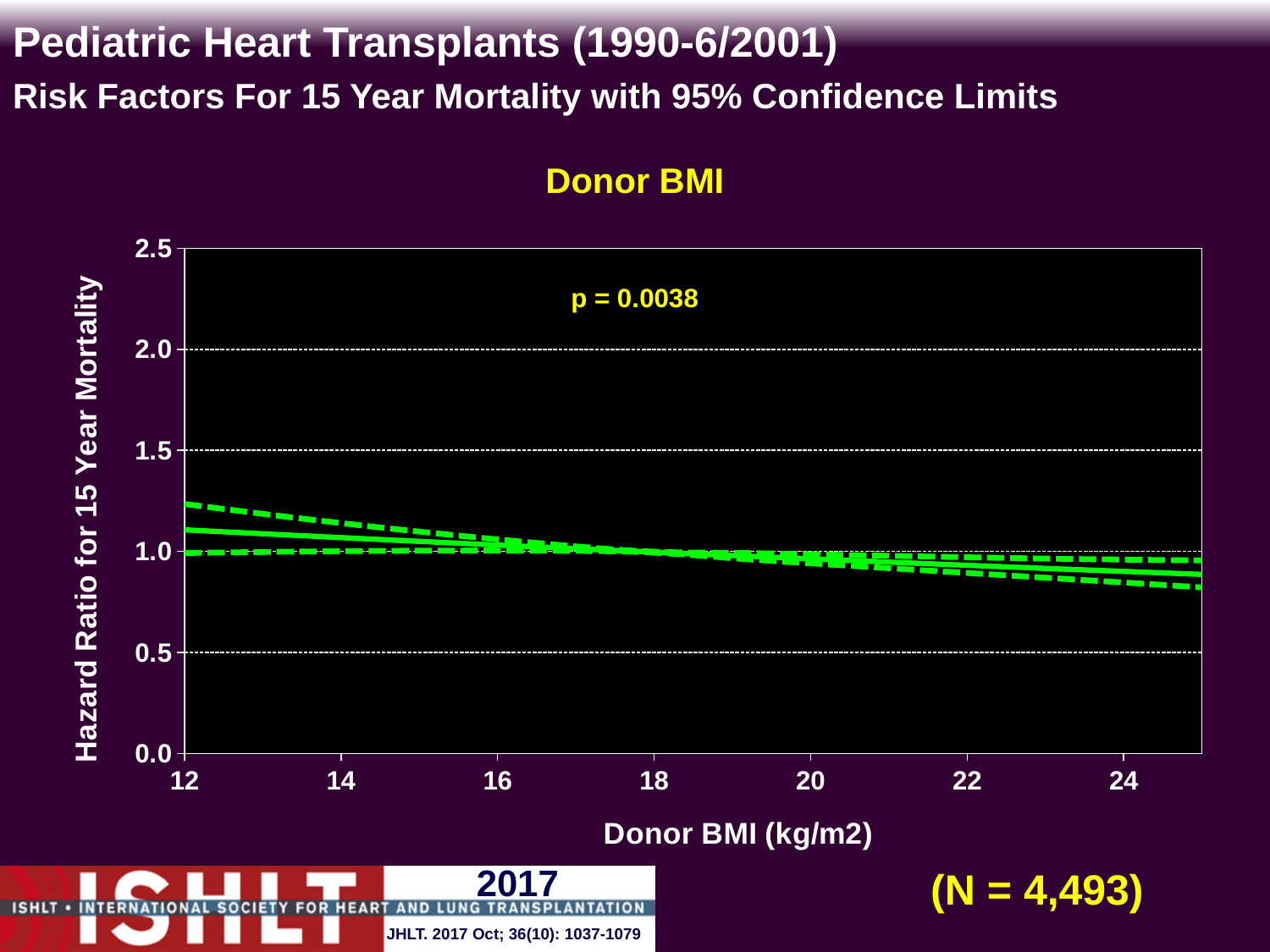
Is the upper 95% confidence limit at a donor BMI of 12 greater or less than 1.5? less How many labeled tick marks are on the x axis? 7 How many lines are plotted on the chart? 3 Does the hazard ratio for 15 year mortality rise or fall as donor BMI increases? fall What kind of chart is shown on the slide? line chart Is the hazard ratio (solid line) at a donor BMI of 12 greater or less than 1.0? greater What p-value is shown on the chart? p = 0.0038 Is the lower 95% confidence limit at a donor BMI of 24 greater or less than 0.5? greater What is the sample size (N) shown on the slide? N = 4,493 Is the hazard ratio at a donor BMI of 12 larger or smaller than the hazard ratio at a donor BMI of 24? larger